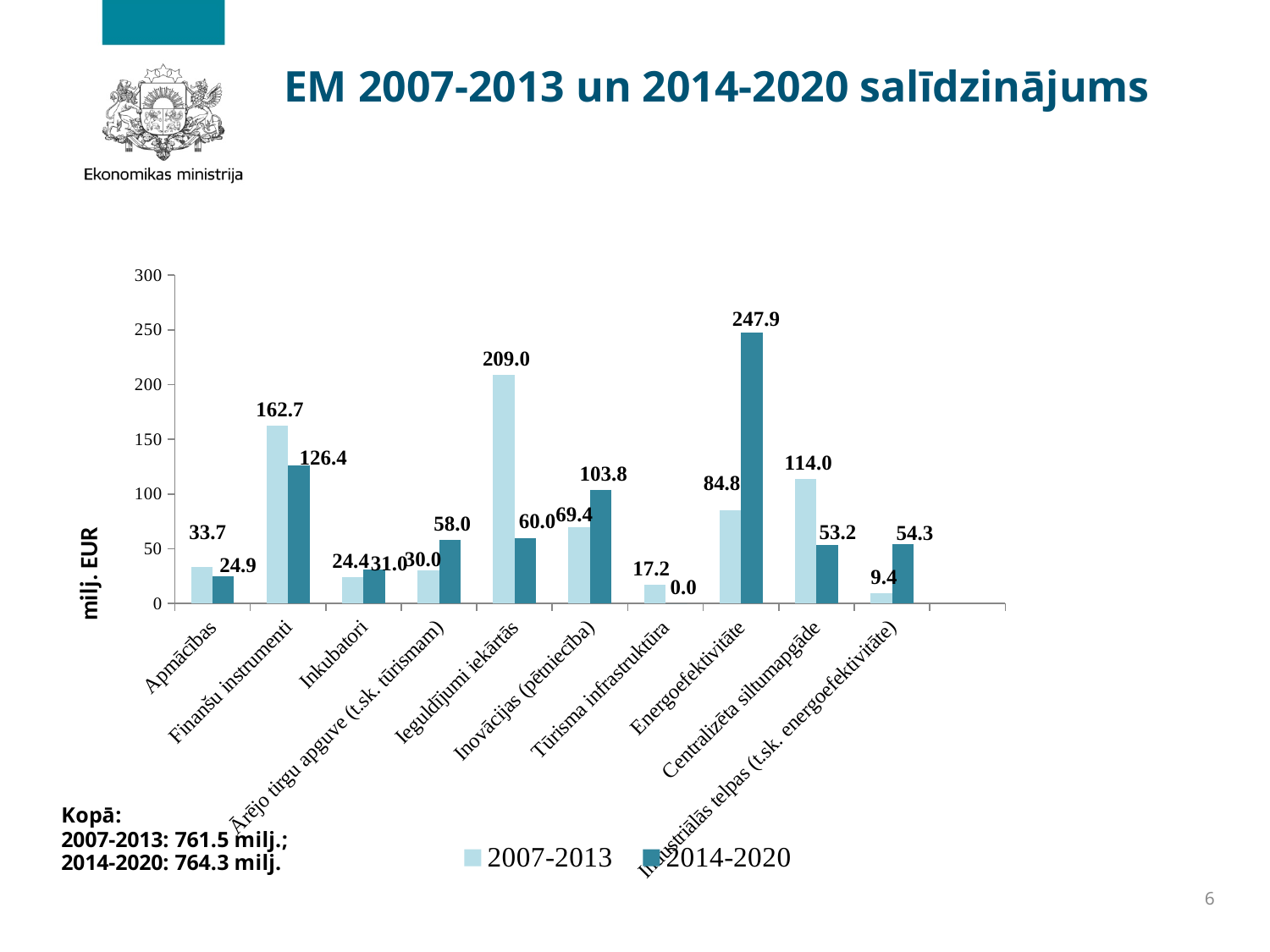
How many categories are shown on the x axis of the chart? 10 How many series does the legend list? 2 What is the value for Energoefektivitāte in the 2014-2020 series? 247.9 What is the difference between the 2007-2013 and 2014-2020 values for Finanšu instrumenti? 36.3 What kind of chart is shown on the slide? Bar chart For Inovācijas (pētniecība), which series has the larger value, 2007-2013 or 2014-2020? 2014-2020 Which category has the lowest value in the 2014-2020 series? Tūrisma infrastruktūra What is the label of the y axis? milj. EUR What is the total of the 2007-2013 and 2014-2020 values for Centralizēta siltumapgāde? 167.2 What is the value for Tūrisma infrastruktūra in the 2014-2020 series? 0.0 Which category has the highest value in the 2007-2013 series? Ieguldījumi iekārtās What is the value for Ieguldījumi iekārtās in the 2007-2013 series? 209.0